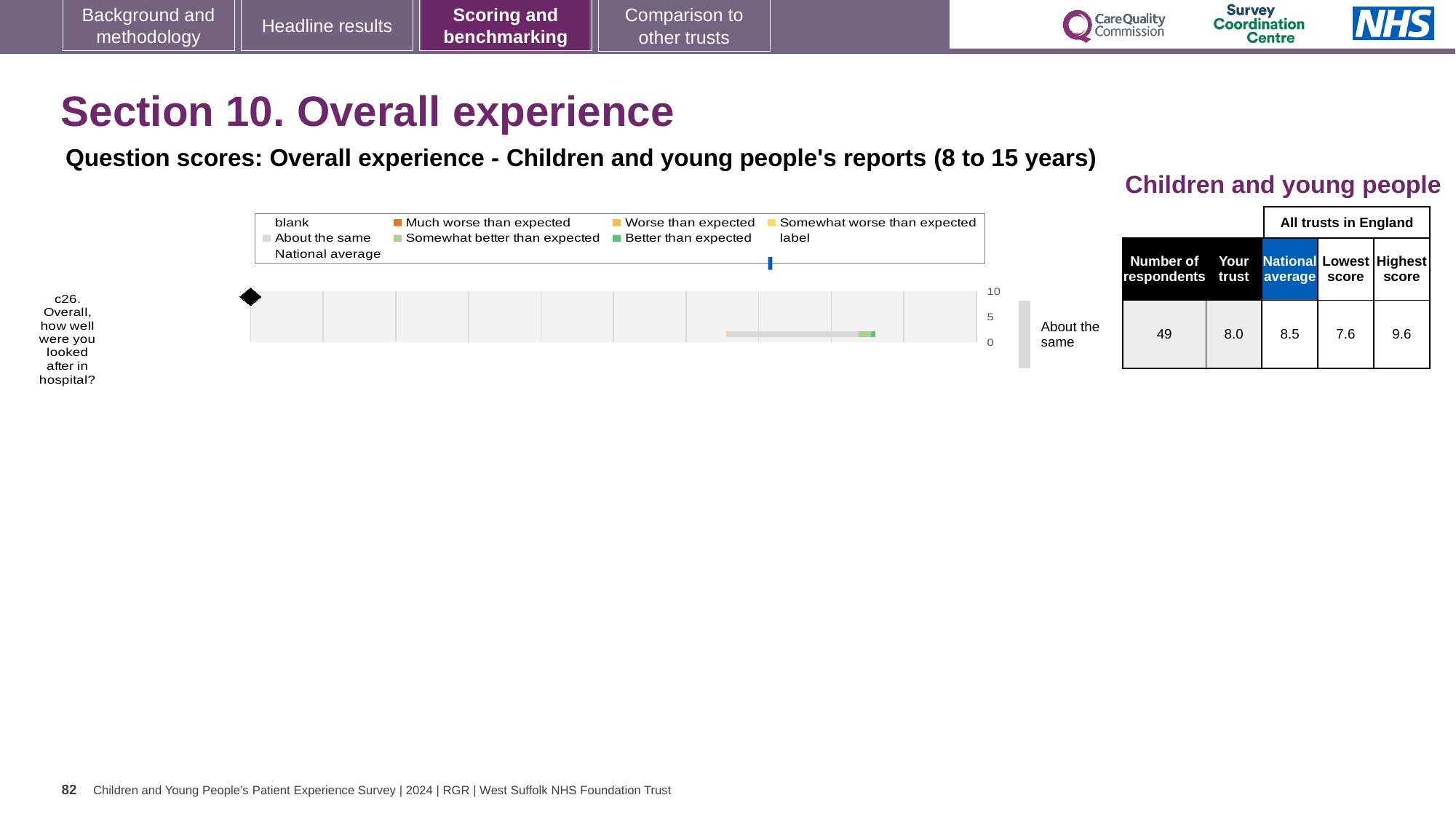
In the table beside the chart, what is the lowest score among all trusts in England for c26? 7.6 How many respondents answered question c26? 49 What is the difference between the highest score and the lowest score for c26? 2.0 What colour represents 'Better than expected' in the chart legend? green How many questions (categories) are plotted in the chart? 1 What benchmark category is shown next to the bar for c26 'Overall, how well were you looked after in hospital?'? About the same What colour represents 'Much worse than expected' in the chart legend? orange What kind of chart is shown for question c26? bar chart In the table beside the chart, what is the national average score for c26? 8.5 In the table beside the chart, what is the 'Your trust' score for c26? 8.0 Which is larger for c26: the 'Your trust' score or the national average? National average In the table beside the chart, what is the highest score among all trusts in England for c26? 9.6